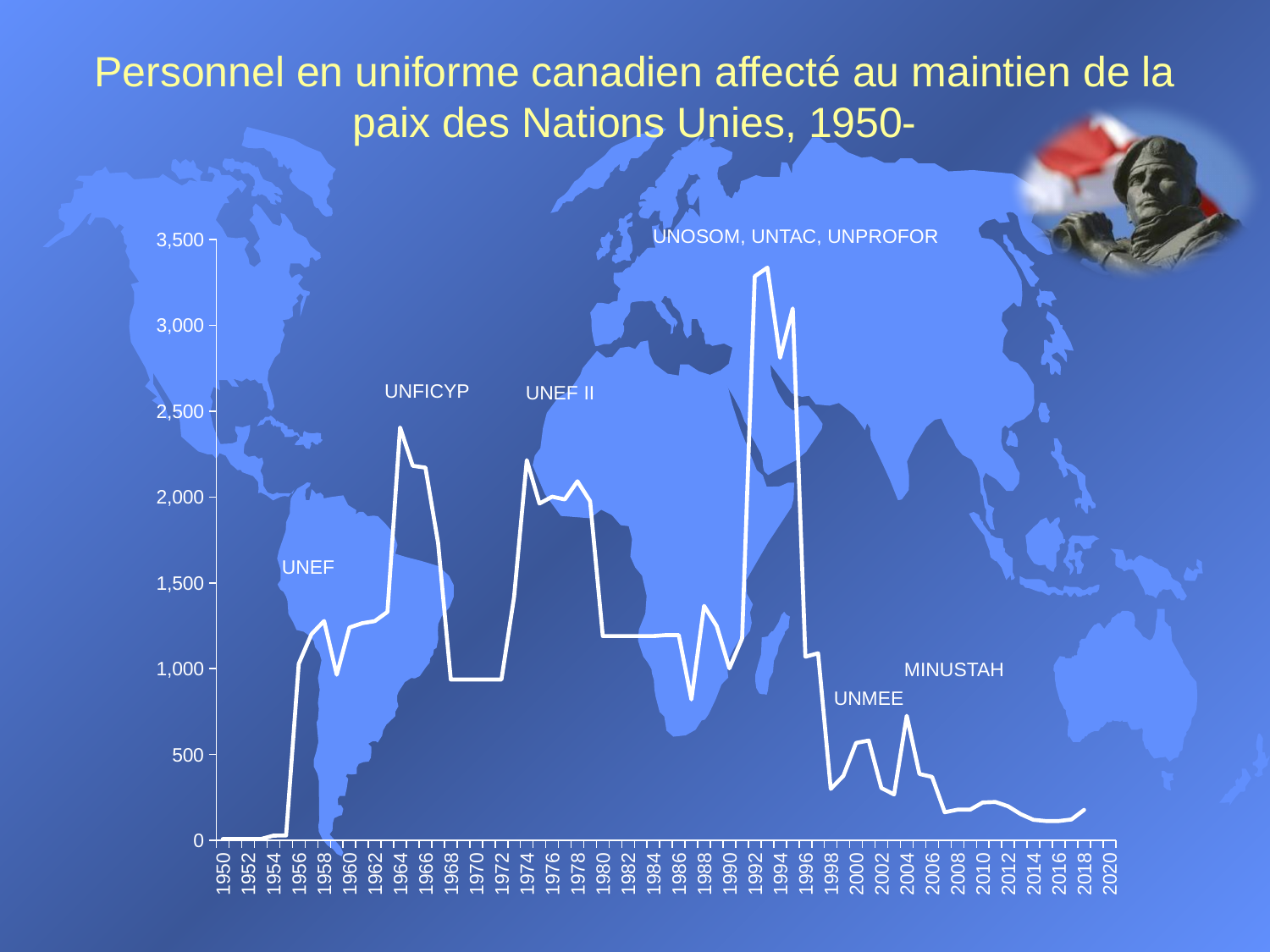
What is the title of the chart on the slide? Personnel en uniforme canadien affecté au maintien de la paix des Nations Unies, 1950- Does the line rise or fall between 1954 and 1957? rise Is the value for 1998 greater or less than 500? less Is the value for 1993 greater or less than 3,000? greater Is the value for 1950 greater or less than 500? less Which mission label is placed next to the highest peak of the line? UNOSOM, UNTAC, UNPROFOR What kind of chart is shown on the slide? line chart Does the line rise or fall between 1996 and 2000? fall In which decade does the line reach its highest value? 1990s